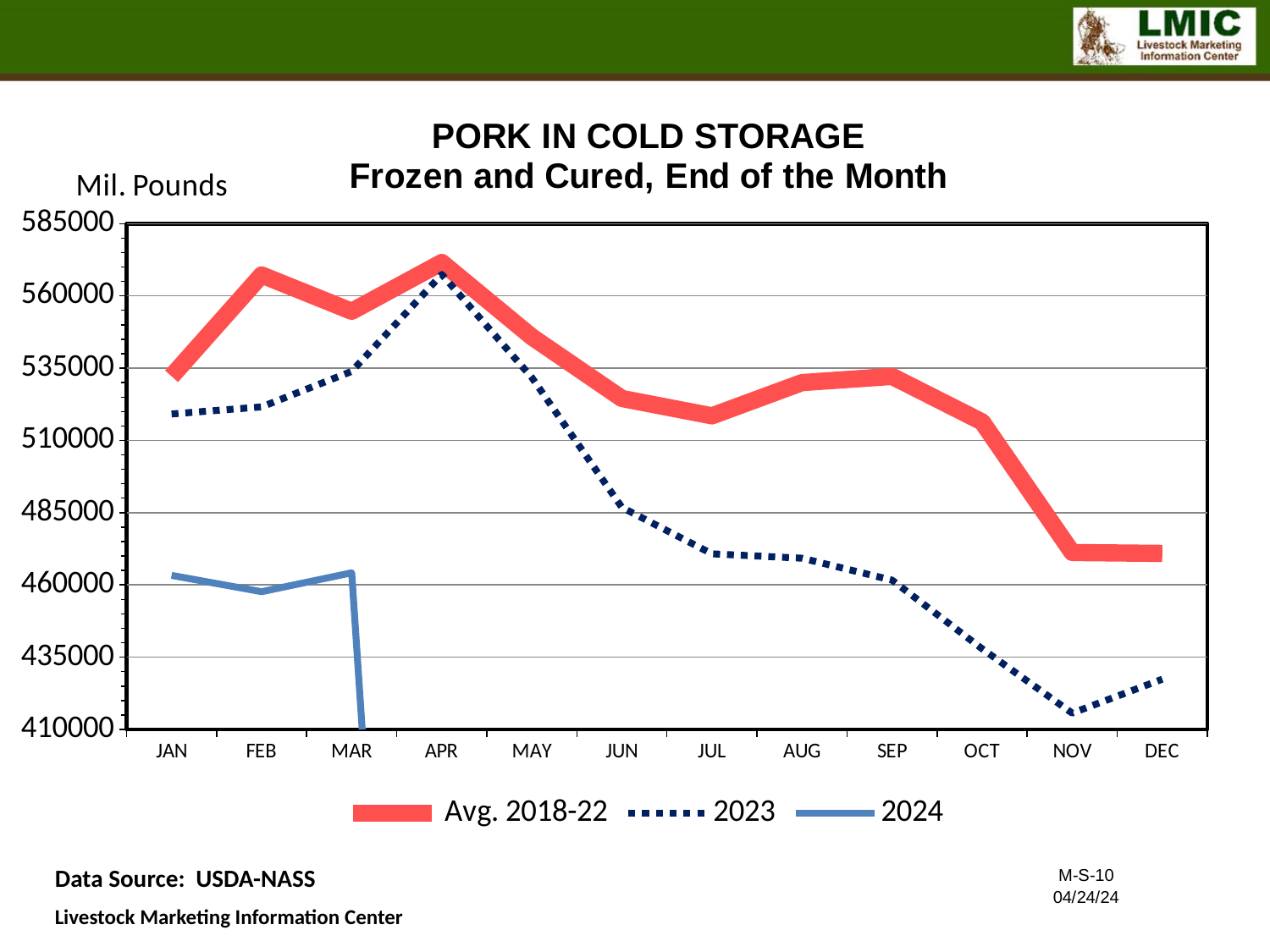
Does the 2023 series rise or fall from APR to NOV? Fall Which is larger in JUN, the Avg. 2018-22 value or the 2023 value? Avg. 2018-22 How many months are shown on the x axis? 12 In which month does the 2023 series reach its highest value? APR What type of chart is shown on the slide? Line chart Is the 2023 value for JUL greater or less than 485000? less What unit is shown on the y axis label? Mil. Pounds In which month does the Avg. 2018-22 series reach its highest value? APR In which month does the 2023 series reach its lowest value? NOV How many series does the legend list? 3 Is the Avg. 2018-22 value for APR greater or less than 560000? greater Is the 2024 value for JAN greater or less than 485000? less